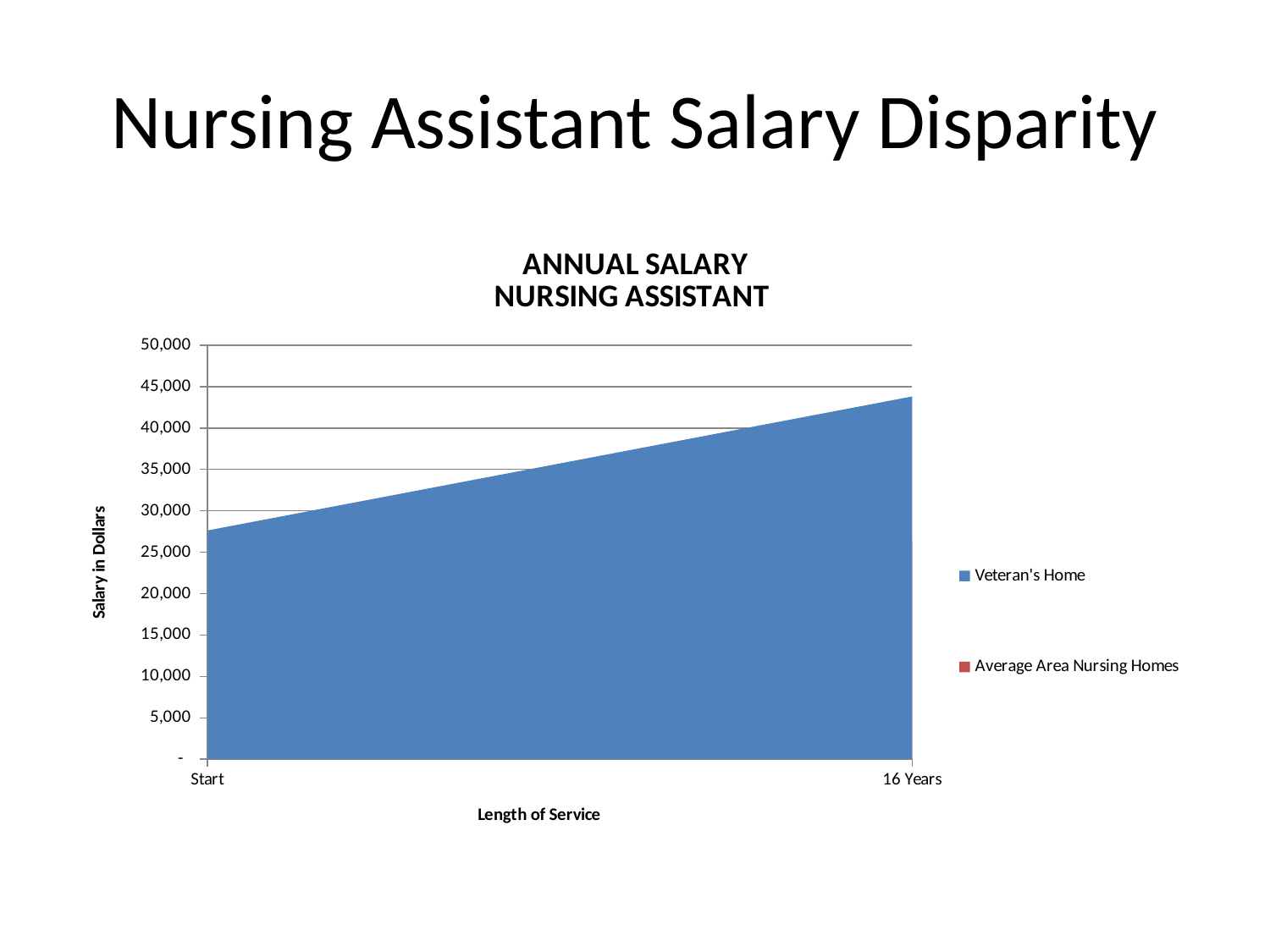
Which is larger for Veteran's Home: the salary at Start or at 16 Years? 16 Years What is the label of the x axis? Length of Service How many series does the legend list? 2 Does the Veteran's Home salary rise or fall from Start to 16 Years? Rises How many categories are shown on the x axis? 2 What kind of chart is shown on the slide? Area chart What is the title of the chart? ANNUAL SALARY NURSING ASSISTANT Is the Veteran's Home salary at Start greater or less than 30,000? less Is the Veteran's Home salary at Start greater or less than 25,000? greater Is the Veteran's Home salary at 16 Years greater or less than 45,000? less